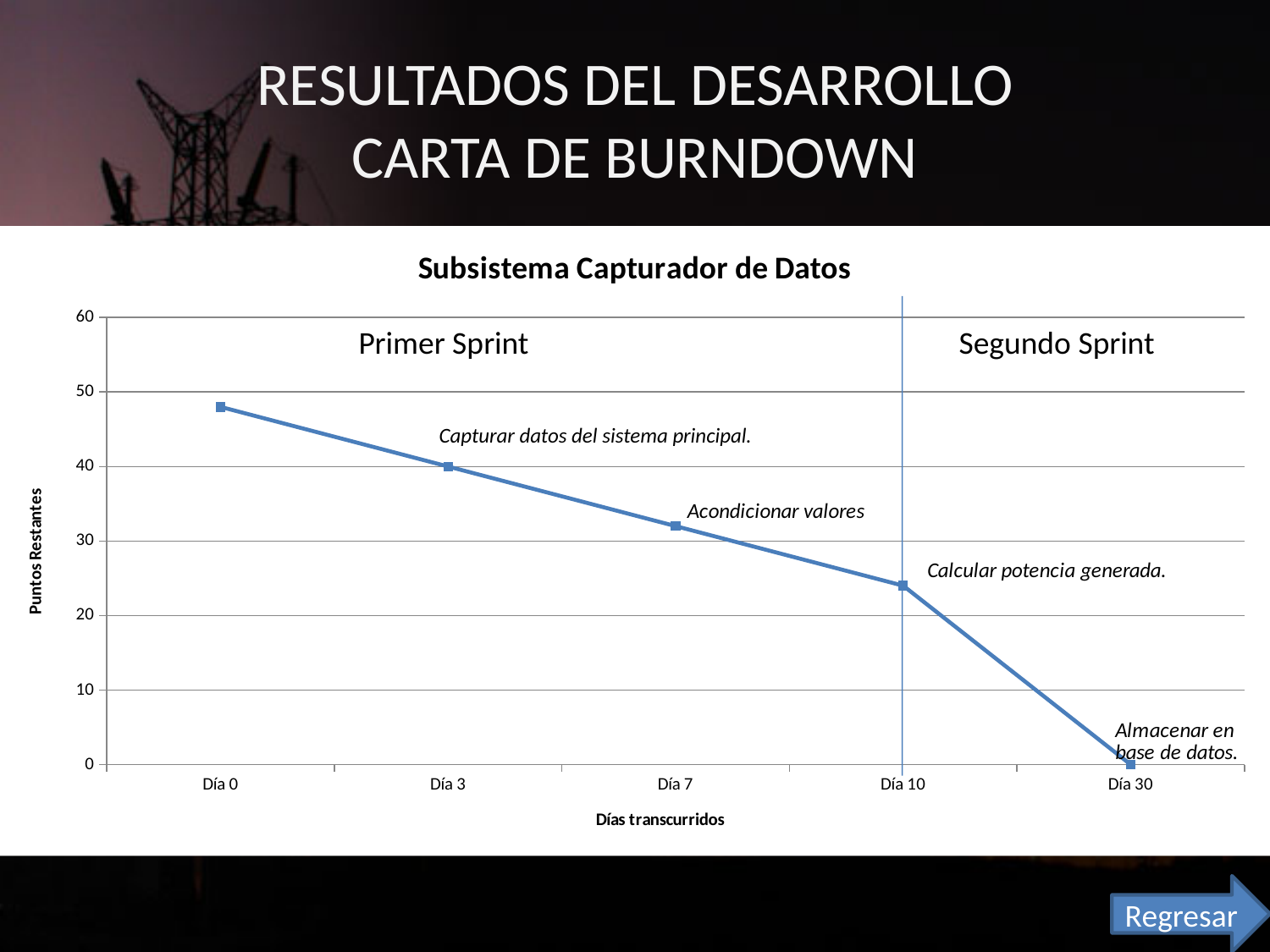
What is the value of Puntos Restantes at Día 3? 40 Which day has the lowest number of Puntos Restantes? Día 30 Do the values rise or fall as the days progress along the x axis? fall Is the value for Día 0 greater or less than 40? greater What type of chart is shown on the slide? line chart Which is larger, the value at Día 3 or the value at Día 10? Día 3 Is the value for Día 10 greater or less than 30? less How many data points are plotted on the line? 5 Which day has the highest number of Puntos Restantes? Día 0 Is the value for Día 7 greater or less than 30? greater What is the title of the chart? Subsistema Capturador de Datos What is the value of Puntos Restantes at Día 30? 0